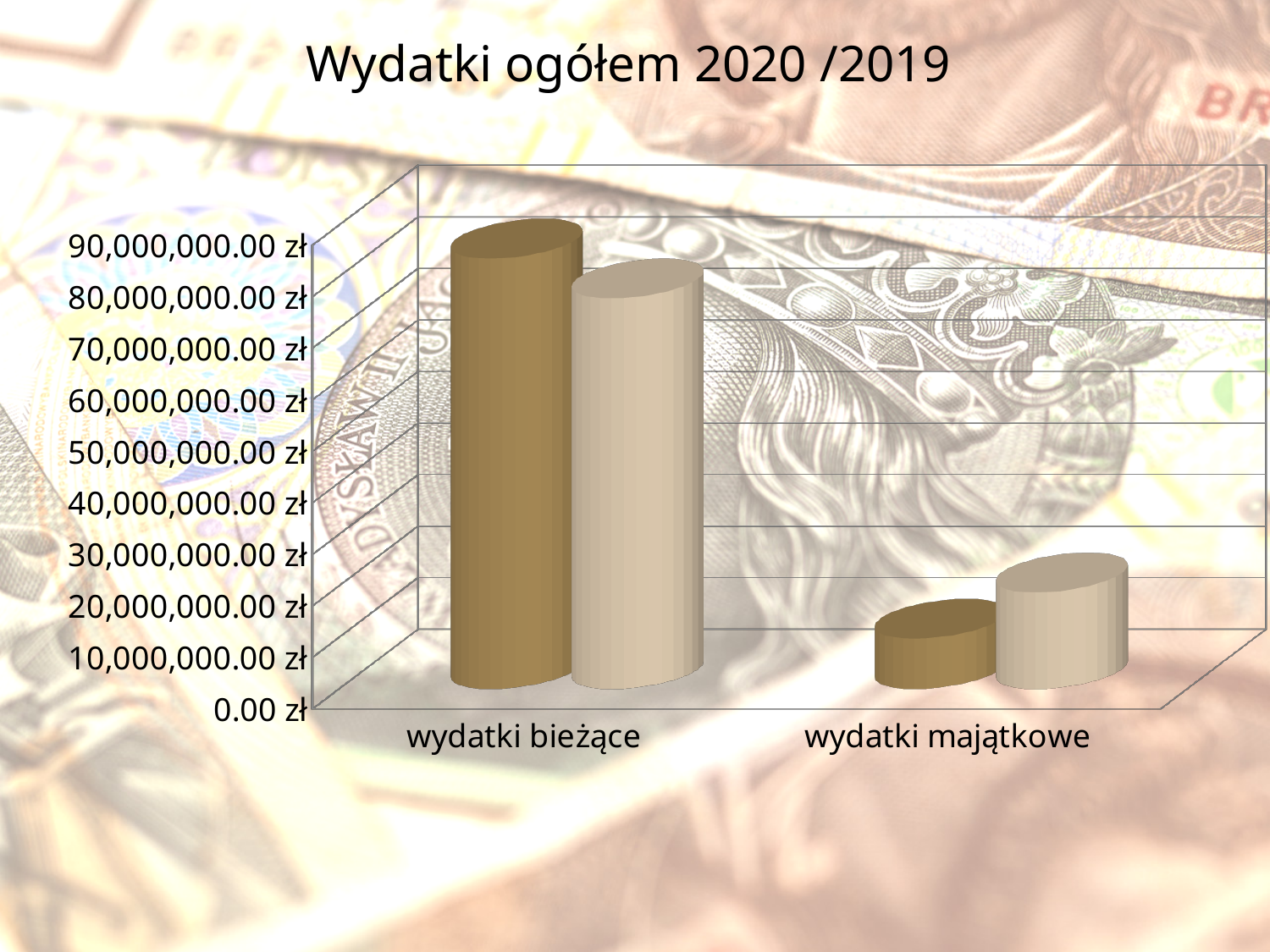
For wydatki majątkowe, which bar is taller: the darker brown bar or the lighter beige bar? the lighter beige bar Which category has the shortest bars in the chart? wydatki majątkowe Which category has the tallest bars in the chart? wydatki bieżące For wydatki bieżące, which bar is taller: the darker brown bar or the lighter beige bar? the darker brown bar What kind of chart is shown on the slide? bar chart What is the highest value labelled on the vertical axis of the chart? 90,000,000.00 zł What is the title of the chart? Wydatki ogółem 2020 /2019 How many bars are plotted for each category in the chart? 2 Is the value of the darker brown bar for wydatki bieżące greater or less than 50,000,000.00 zł? greater Is the value of the darker brown bar for wydatki majątkowe greater or less than 40,000,000.00 zł? less Is the value of the lighter beige bar for wydatki majątkowe greater or less than 50,000,000.00 zł? less How many categories are shown on the x axis of the chart? 2